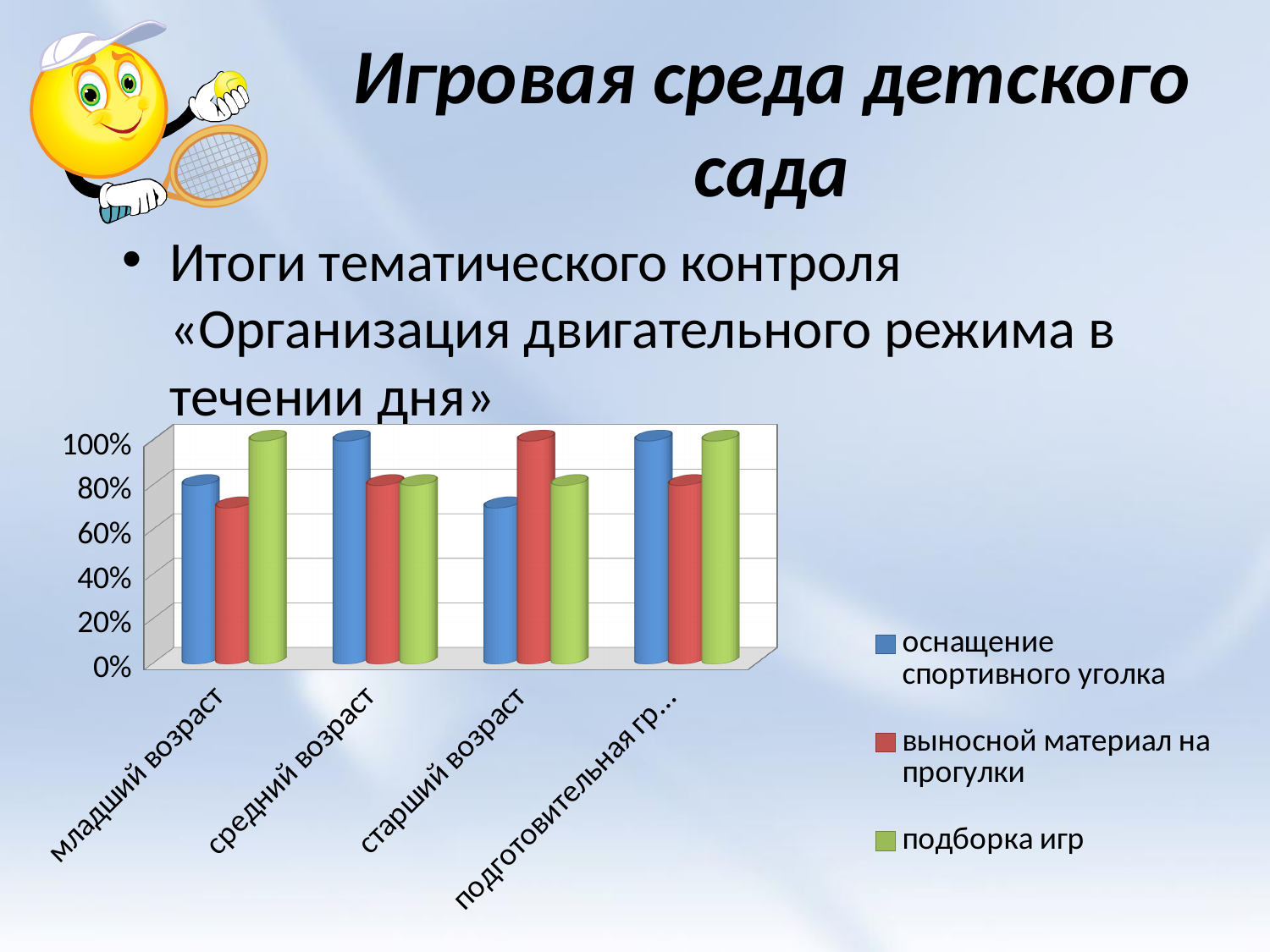
In 'старший возраст', which is larger: 'оснащение спортивного уголка' or 'выносной материал на прогулки'? выносной материал на прогулки In 'младший возраст', which is larger: 'подборка игр' or 'выносной материал на прогулки'? подборка игр Is the value for 'оснащение спортивного уголка' in 'старший возраст' greater or less than 80%? less For the series 'выносной материал на прогулки', which category has the highest value? старший возраст Is the value for 'выносной материал на прогулки' in 'старший возраст' greater or less than 80%? greater What colour represents 'подборка игр' in the chart legend? green How many series does the chart legend list? 3 For the series 'оснащение спортивного уголка', which category has the lowest value? старший возраст What kind of chart is shown on the slide? bar chart Is the value for 'оснащение спортивного уголка' in 'средний возраст' greater or less than 80%? greater How many age-group categories are shown on the x axis of the chart? 4